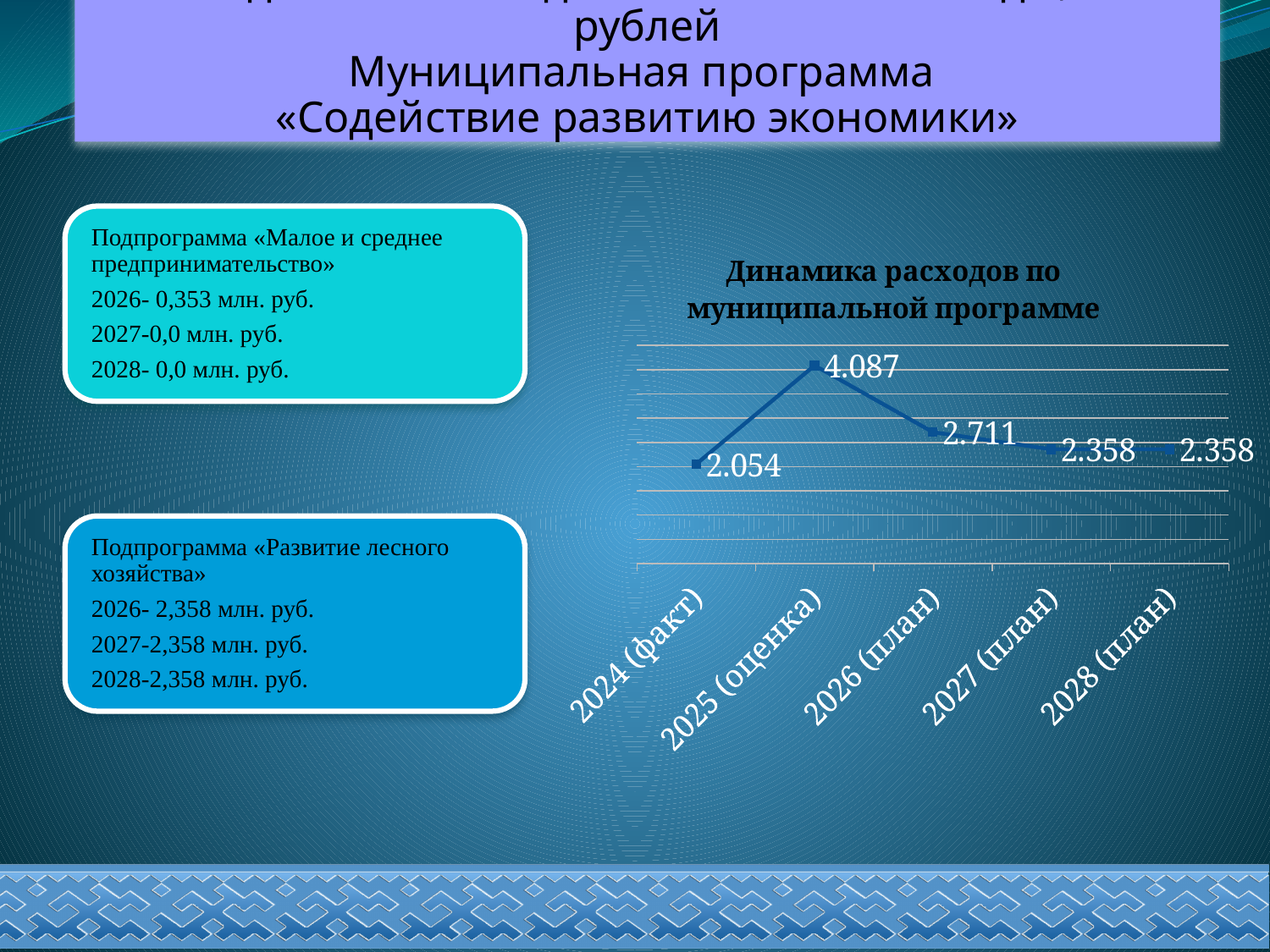
What is the value for 2026 (план)? 2.711 What is the title of the chart? Динамика расходов по муниципальной программе What type of chart is shown on the slide? line chart What is the difference between the values for 2025 (оценка) and 2026 (план)? 1.376 Which category has the lowest value? 2024 (факт) What is the value for 2028 (план)? 2.358 What is the value for 2024 (факт)? 2.054 Which category has the highest value? 2025 (оценка) How many categories are plotted on the x axis? 5 What is the value for 2025 (оценка)? 4.087 Do the values rise or fall from 2025 (оценка) to 2027 (план)? fall Which is larger, the value for 2026 (план) or the value for 2027 (план)? 2026 (план)